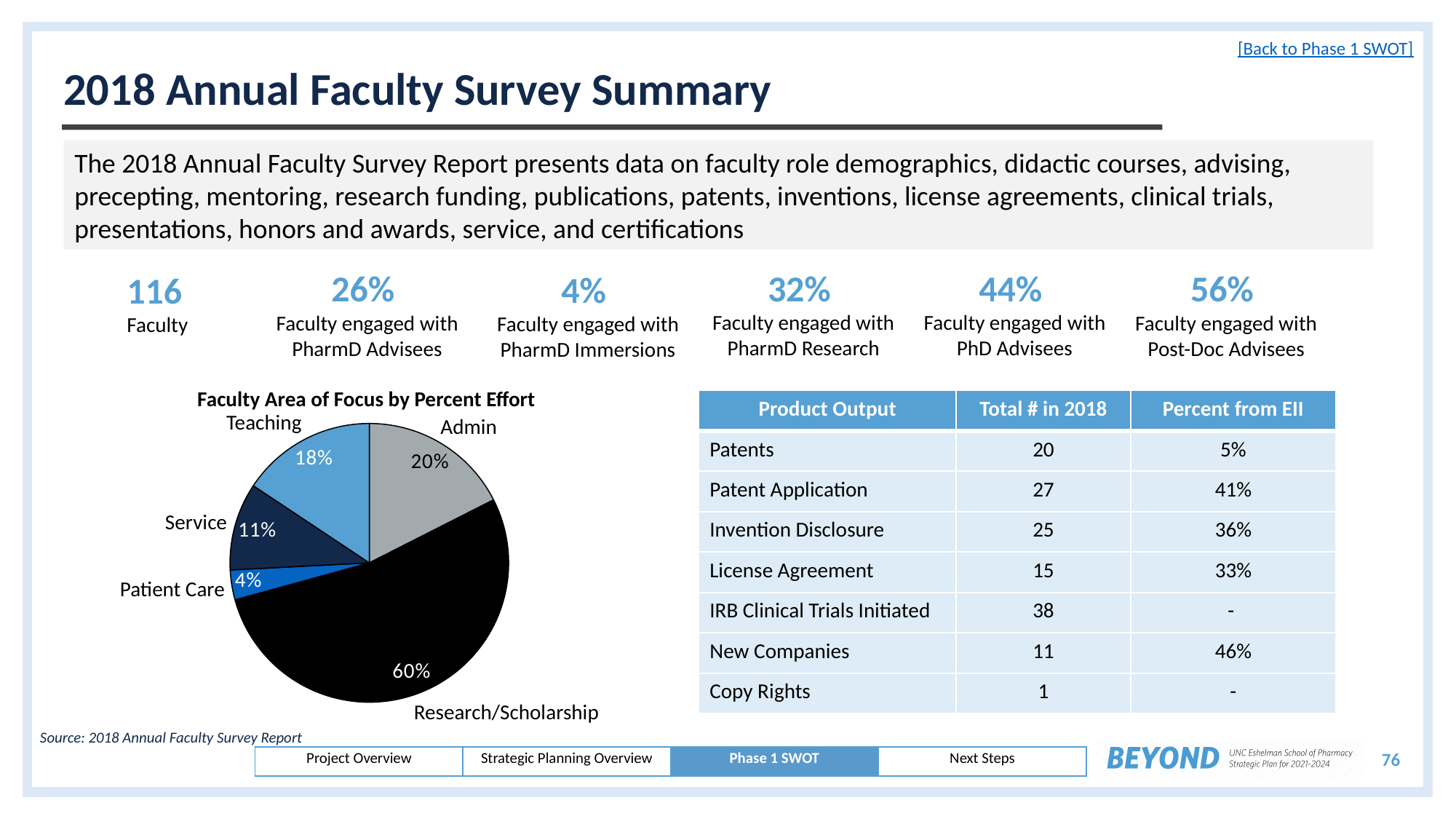
What is the difference between the Admin and Teaching percentages in the pie chart? 2% Which area of focus has the smallest slice in the pie chart? Patient Care Which area of focus has the largest slice in the pie chart? Research/Scholarship What percent effort is shown for Service in the pie chart? 11% What percent effort is shown for Patient Care in the pie chart? 4% What percent effort is shown for Research/Scholarship in the pie chart? 60% What type of chart is shown on the slide? Pie chart What percent effort is shown for Admin in the pie chart? 20% How many slices does the pie chart have? 5 What is the title of the pie chart? Faculty Area of Focus by Percent Effort Which is larger in the pie chart, Service or Teaching? Teaching What percent effort is shown for Teaching in the pie chart? 18%